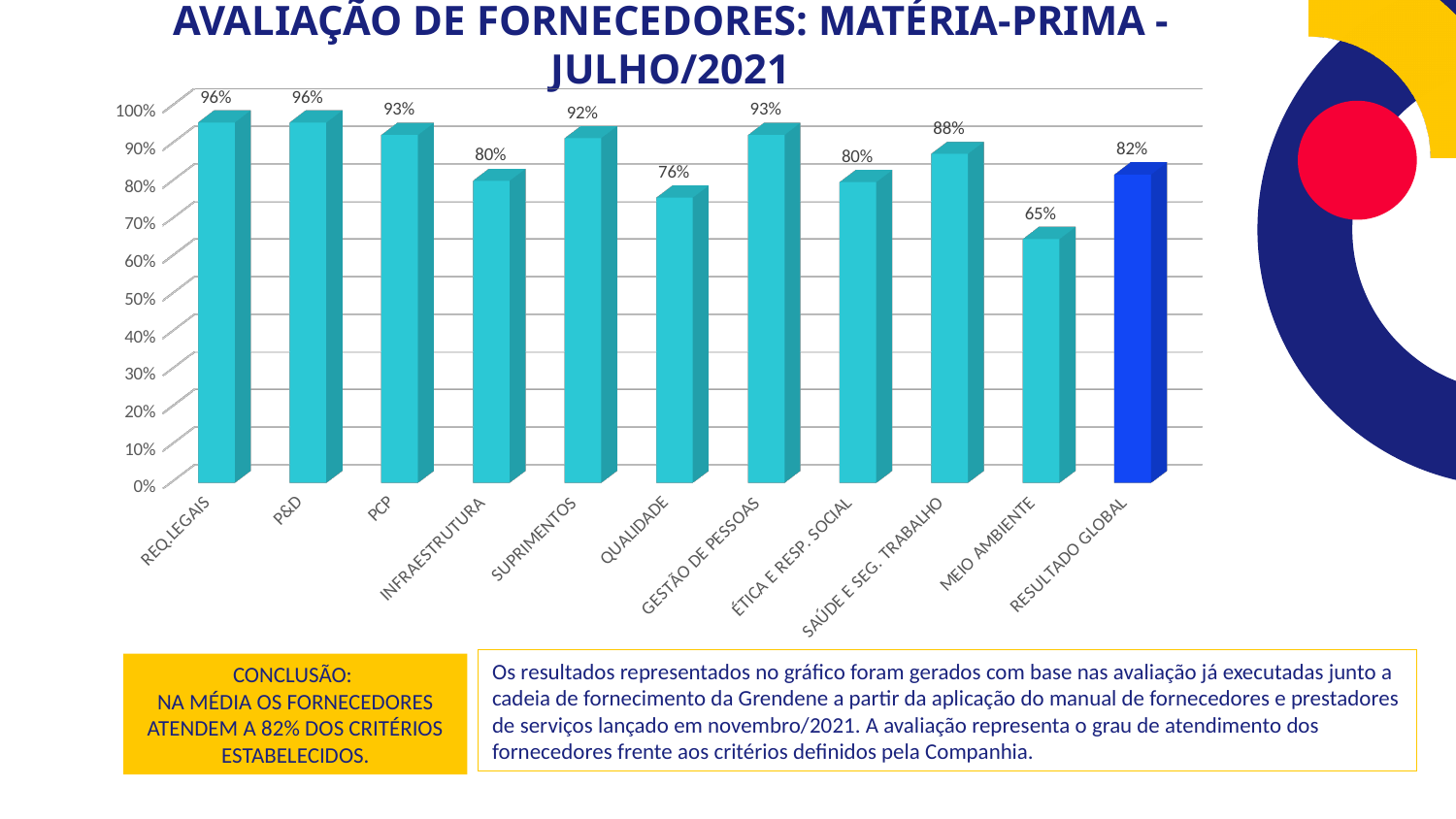
What is the value for RESULTADO GLOBAL? 82% What is the value for SAÚDE E SEG. TRABALHO? 88% Which is larger, the value for INFRAESTRUTURA or the value for SAÚDE E SEG. TRABALHO? SAÚDE E SEG. TRABALHO What is the value for SUPRIMENTOS? 92% What is the value for QUALIDADE? 76% What is the difference between the values for GESTÃO DE PESSOAS and ÉTICA E RESP. SOCIAL? 13% What is the difference between the values for PCP and MEIO AMBIENTE? 28% How many categories are shown on the x axis? 11 Which bar is shown in a different colour (dark blue) from the others? RESULTADO GLOBAL What kind of chart is shown on the slide? bar chart Which category has the lowest value? MEIO AMBIENTE Is the value for MEIO AMBIENTE greater or less than 70%? less